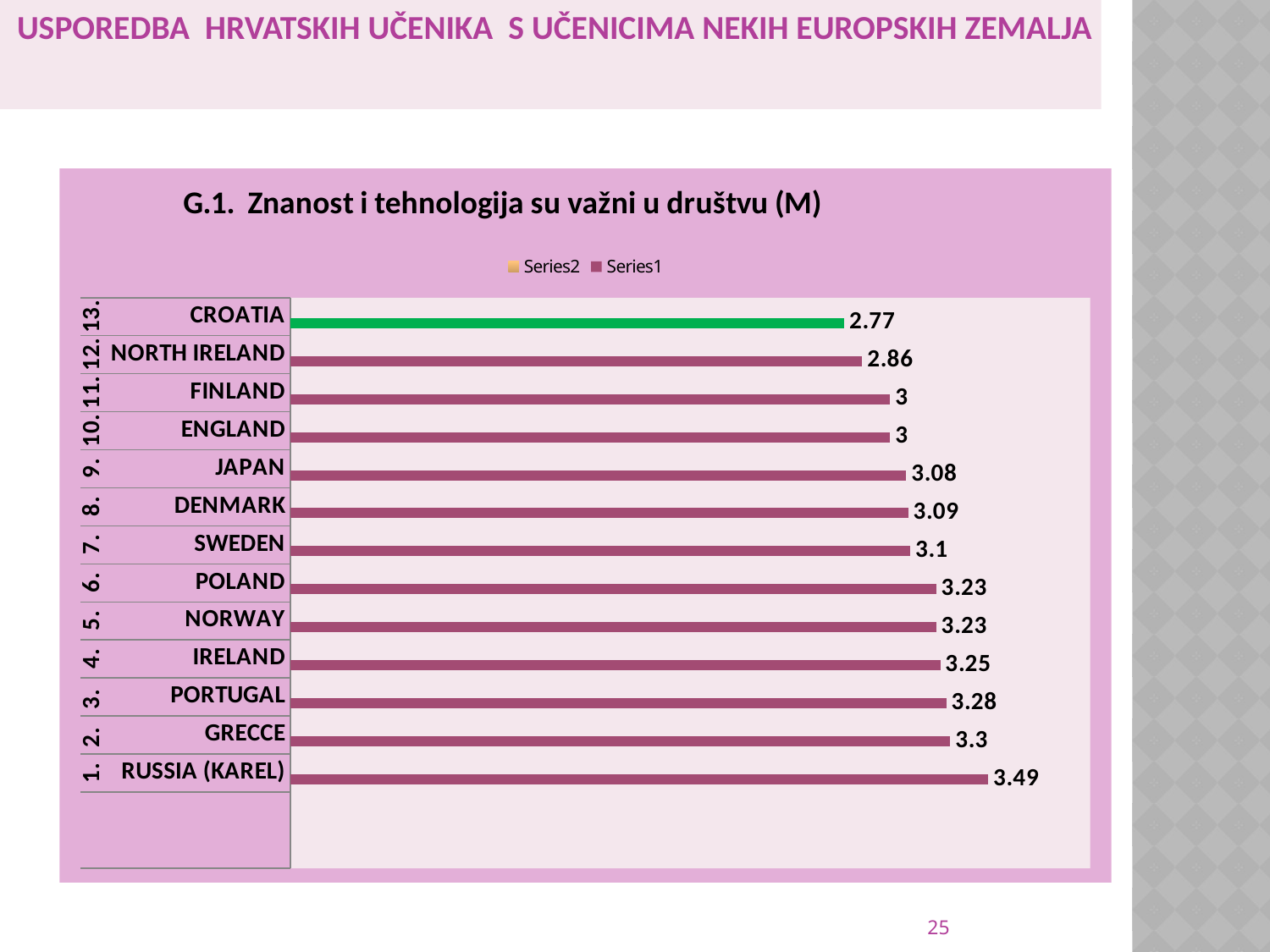
What type of chart is shown on the slide? Bar chart How many series does the legend list? 2 Which country has the highest value? RUSSIA (KAREL) Which has a larger value, IRELAND or SWEDEN? IRELAND How many countries are shown in the chart? 13 Which country has the lowest value? CROATIA What is the value for JAPAN? 3.08 What is the difference between the values for RUSSIA (KAREL) and CROATIA? 0.72 What is the value for CROATIA? 2.77 What is the difference between the values for NORTH IRELAND and CROATIA? 0.09 What is the value for RUSSIA (KAREL)? 3.49 What is the value for PORTUGAL? 3.28